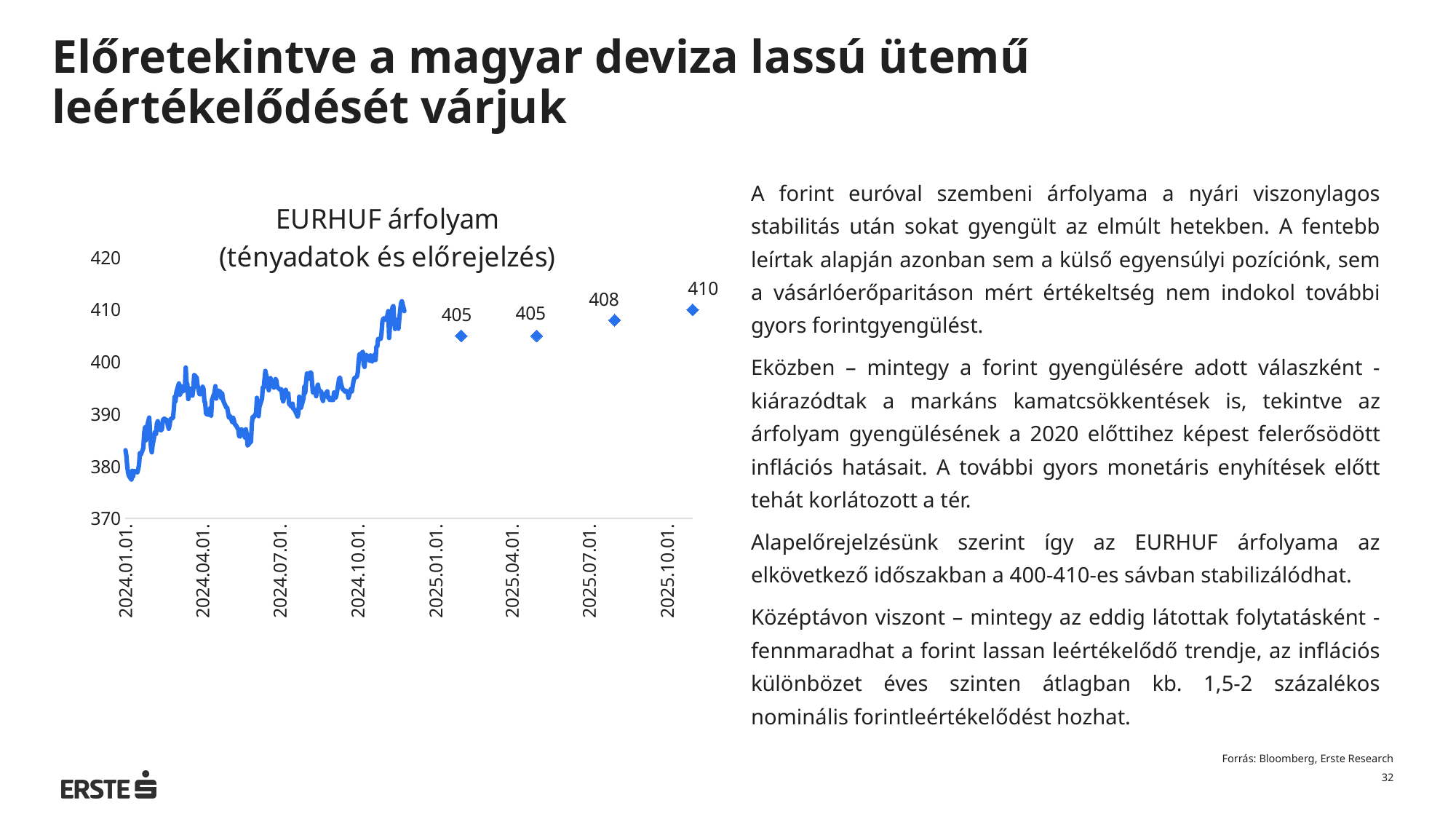
What kind of chart is shown on the slide? line chart Do the forecast values rise or fall from left to right? rise Is the highest point of the actual (line) data greater or less than 400? greater What is the difference between the last forecast value and the first forecast value? 5 What is the value of the first forecast point (the first diamond marker after the line ends)? 405 Is the EURHUF value at the start of 2024 (2024.01.01.) greater or less than 390? less What is the value of the third forecast point in the chart? 408 What is the title of the chart? EURHUF árfolyam (tényadatok és előrejelzés) What is the value of the last (rightmost) forecast point in the chart? 410 Which is larger: the second forecast value or the third forecast value? the third (408) Which forecast point has the highest value? the last one, 410 How many labelled forecast points (diamond markers) are shown in the chart? 4